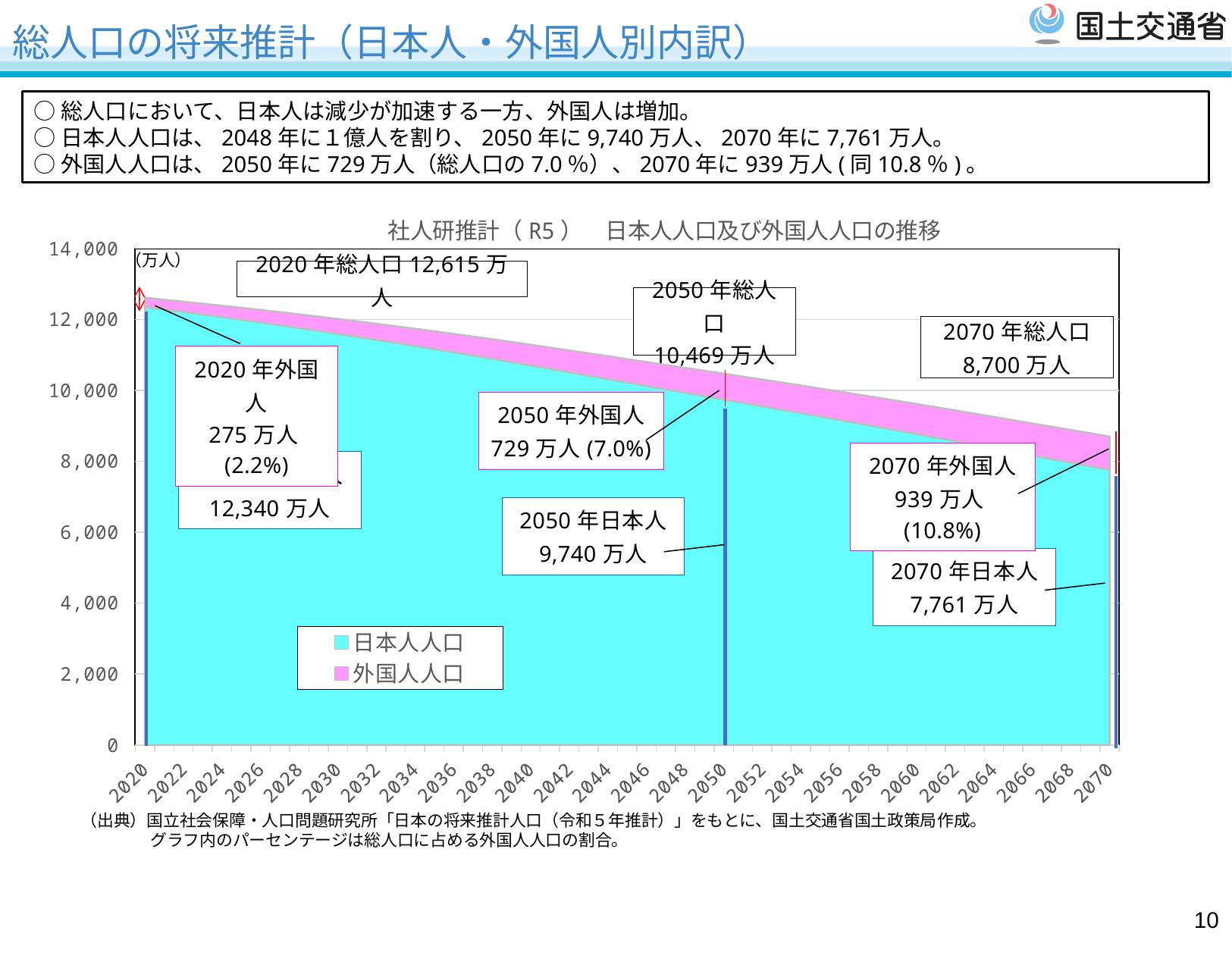
2050年の日本人人口はいくらですか？ 9,740 万人 2050年の日本人人口と2070年の日本人人口の差はいくらですか？ 1,979 万人 このグラフはどの種類のグラフですか？ 面グラフ（積み上げ） 2040年の総人口は10,000より大きいですか、小さいですか？ 大きい 2050年の外国人人口が総人口に占める割合は何％ですか？ 7.0% 凡例にはいくつの系列が示されていますか？ 2 外国人人口は2050年と2070年のどちらが多いですか？ 2070年 2070年の総人口はいくらですか？ 8,700 万人 2020年の総人口はいくらですか？ 12,615 万人 2070年の外国人人口はいくらですか？ 939 万人 日本人人口は2020年から2070年にかけて増加していますか、減少していますか？ 減少 2020年の総人口と2070年の総人口の差はいくらですか？ 3,915 万人